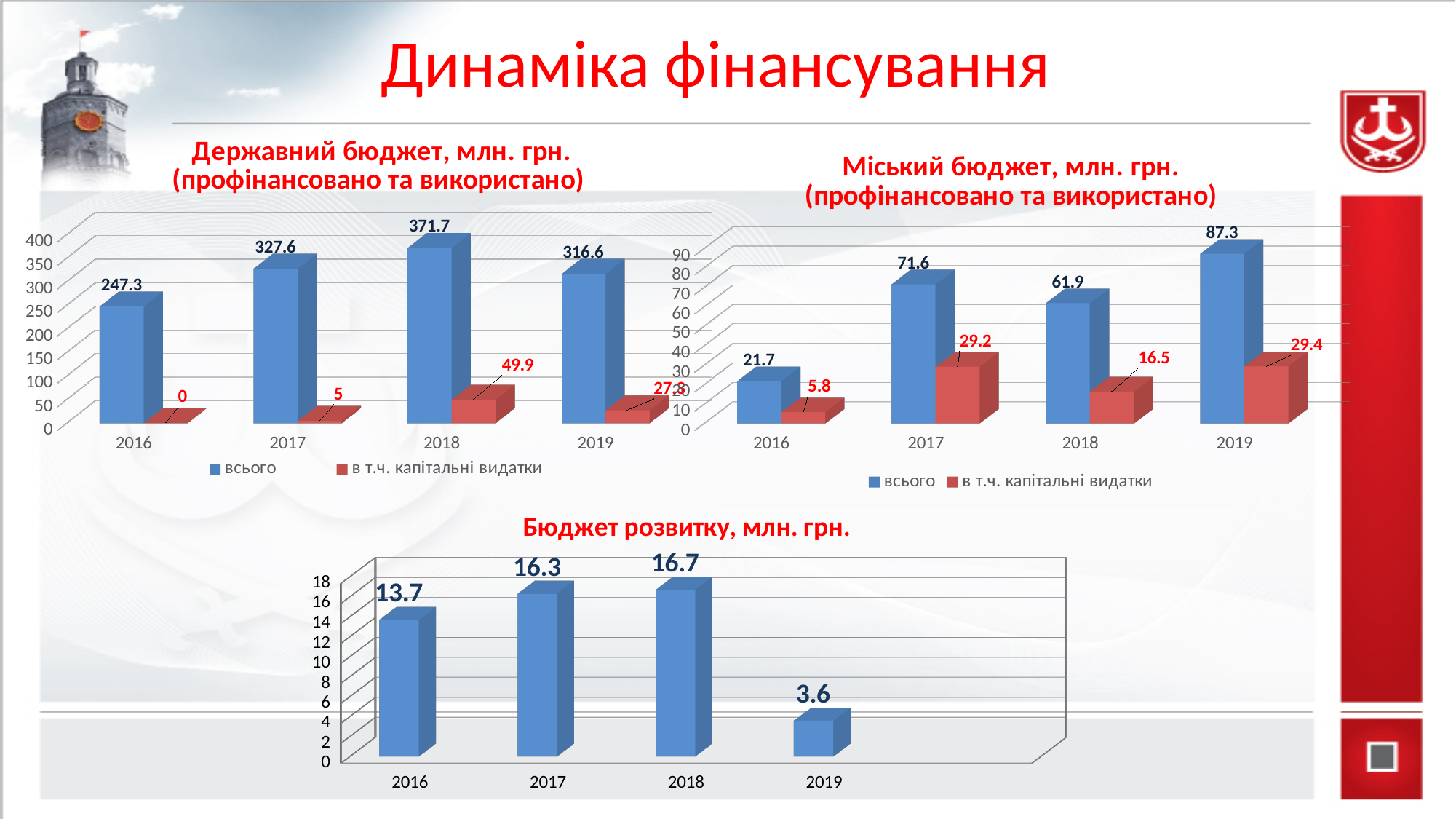
In the 'Бюджет розвитку, млн. грн.' chart, what is the value for 2019? 3.6 How many series does the legend of the 'Міський бюджет, млн. грн.' chart list? 2 In the 'Міський бюджет, млн. грн.' chart, which is larger: the 'всього' value for 2017 or for 2018? 2017 In the 'Державний бюджет, млн. грн.' chart, what is the 'всього' value for 2018? 371.7 In the 'Бюджет розвитку, млн. грн.' chart, which year has the highest value? 2018 In the 'Міський бюджет, млн. грн.' chart, what is the 'в т.ч. капітальні видатки' value for 2018? 16.5 In the 'Міський бюджет, млн. грн.' chart, what is the 'всього' value for 2019? 87.3 In the 'Міський бюджет, млн. грн.' chart, which year has the lowest 'всього' value? 2016 In the 'Державний бюджет, млн. грн.' chart, which year has the highest 'всього' value? 2018 In the 'Державний бюджет, млн. грн.' chart, what is the 'в т.ч. капітальні видатки' value for 2017? 5 In the 'Державний бюджет, млн. грн.' chart, what is the difference between the 'всього' values for 2017 and 2016? 80.3 What kind of chart is the 'Бюджет розвитку, млн. грн.' chart? bar chart